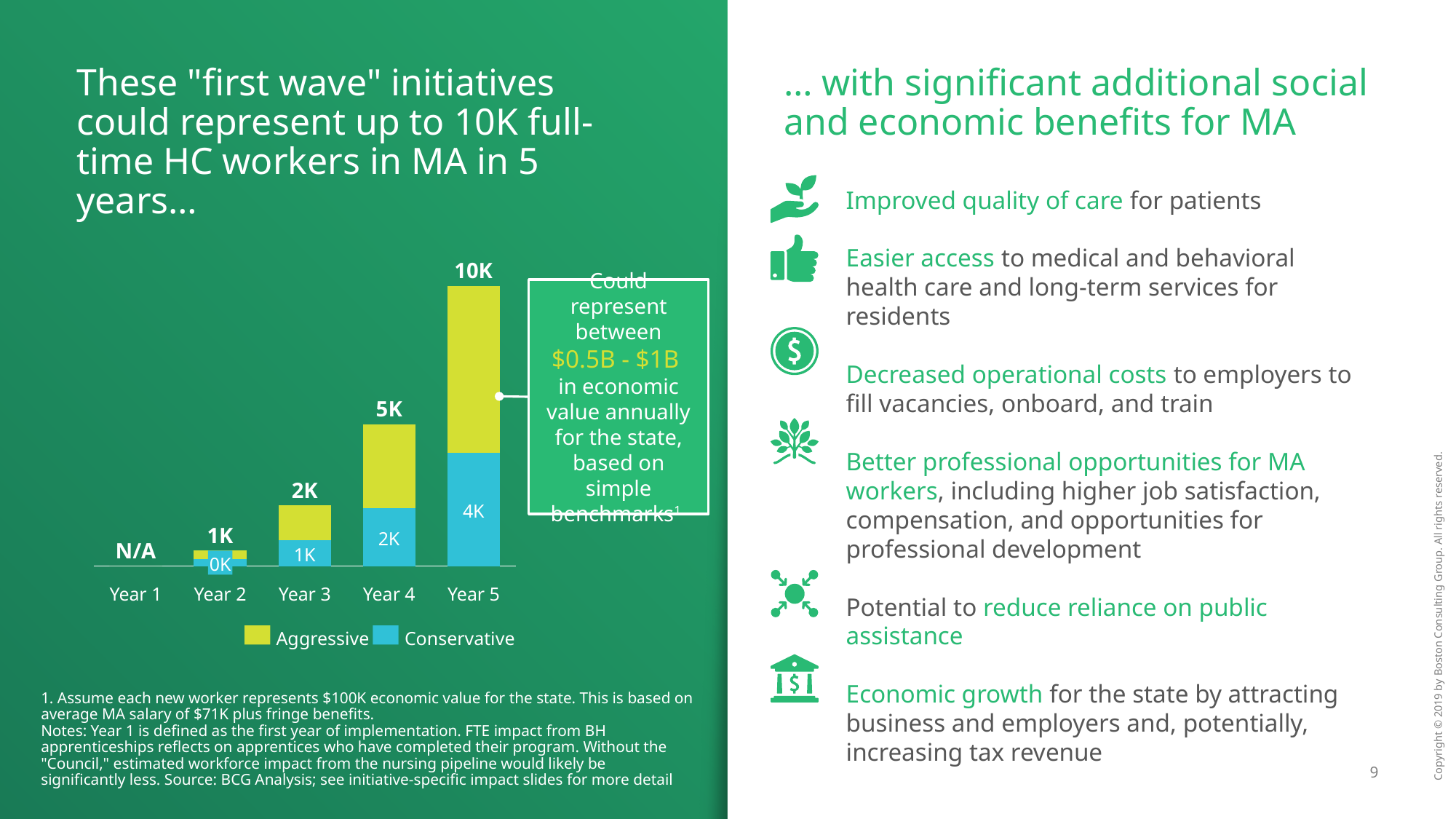
What is the Conservative value for Year 2? 0K What is the Conservative value for Year 4? 2K What kind of chart is shown on the slide? Stacked bar chart What is the total labelled above the Year 5 bar? 10K Do the bar totals rise or fall from Year 2 to Year 5? Rise Which year has the highest bar in the chart? Year 5 What is the total labelled above the Year 4 bar? 5K How many years are shown on the x axis of the chart? 5 What are the two series named in the chart legend? Aggressive and Conservative What is the Conservative value for Year 3? 1K What is the Conservative value for Year 5? 4K How many series does the chart legend list? 2